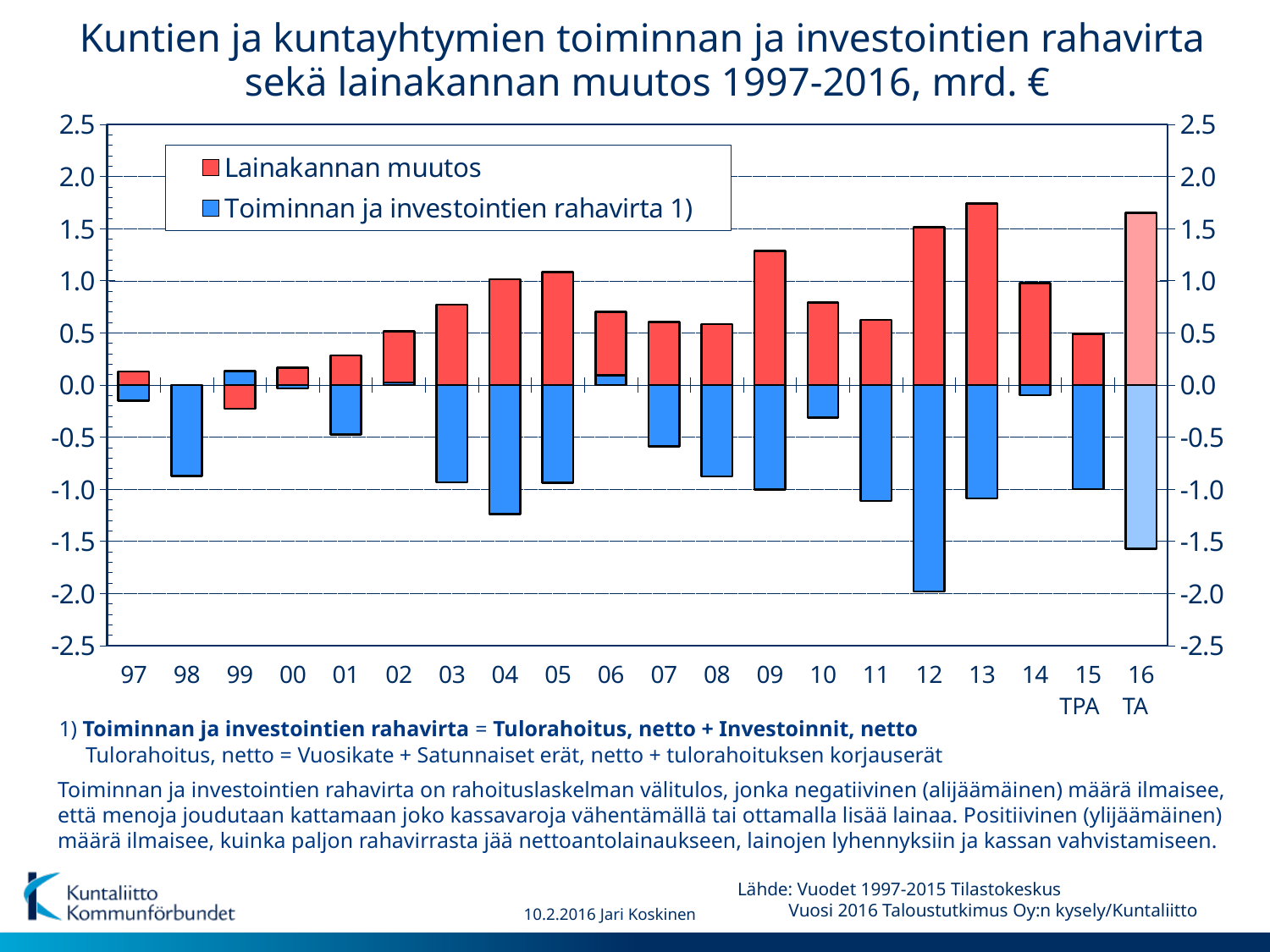
Which year has the larger value for Lainakannan muutos, 13 or 15? 13 Which colour represents Lainakannan muutos in the legend? red Is the value for Toiminnan ja investointien rahavirta 1) in 04 greater or less than -1.0? less Is the value for Toiminnan ja investointien rahavirta 1) in 12 greater or less than -1.5? less Is the value for Lainakannan muutos in 13 greater or less than 1.5? greater Which year has the lowest value for Toiminnan ja investointien rahavirta 1)? 12 How many years are shown on the x axis? 20 Which year has the highest value for Lainakannan muutos? 13 How many series does the legend list? 2 What kind of chart is shown on the slide? bar chart